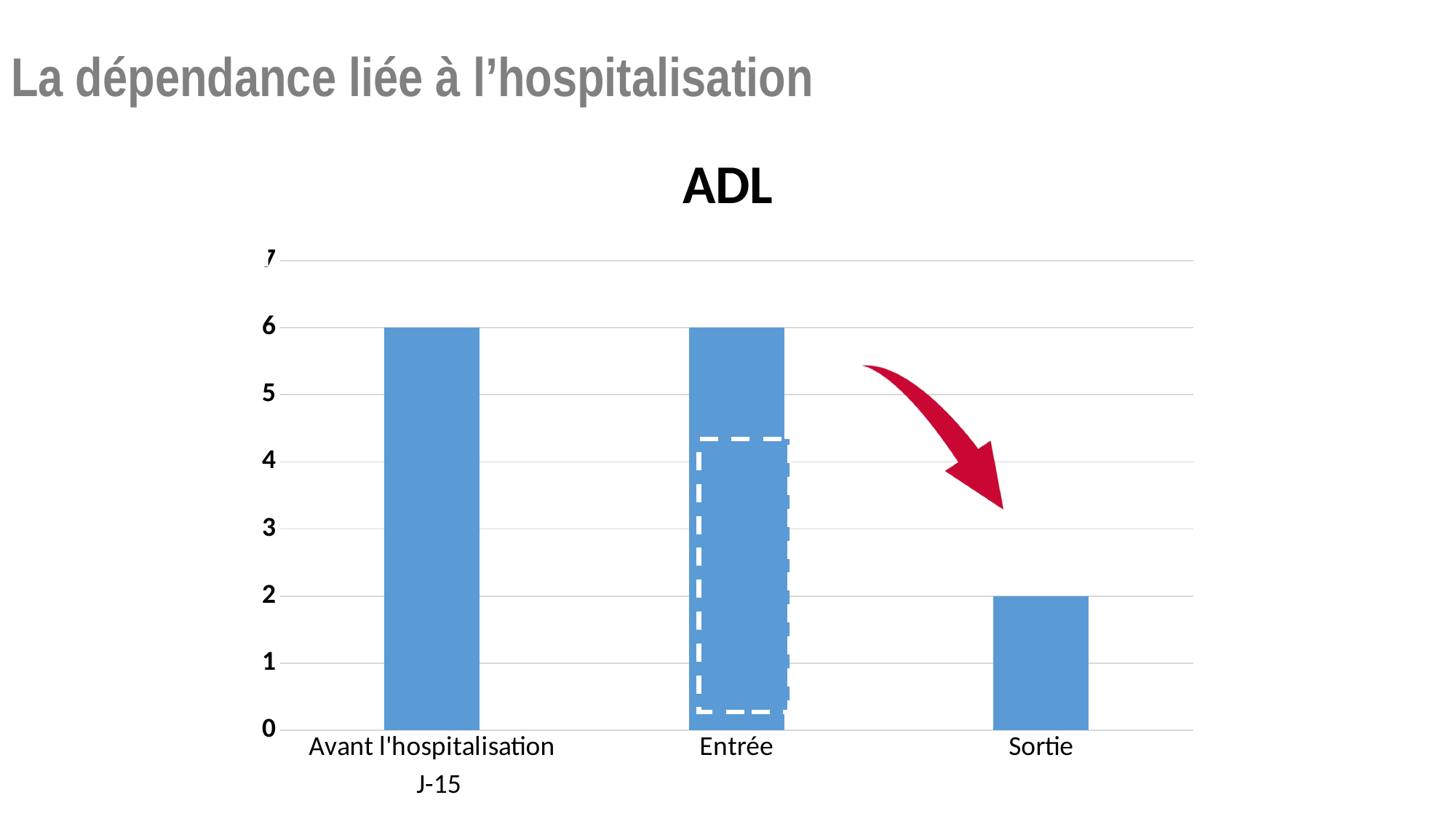
What is the ADL value for Sortie? 2 Is the value for Entrée greater or less than 5? greater Do the values rise or fall from Entrée to Sortie? fall Which is larger, the ADL value for Entrée or for Sortie? Entrée What kind of chart is shown on the slide? bar chart Is the value for Sortie greater or less than 3? less What is the difference between the ADL value at Entrée and at Sortie? 4 What is the ADL value for Avant l'hospitalisation J-15? 6 How many categories are shown on the x axis? 3 What is the title of the chart? ADL Which category has the lowest ADL value? Sortie What is the ADL value for Entrée? 6